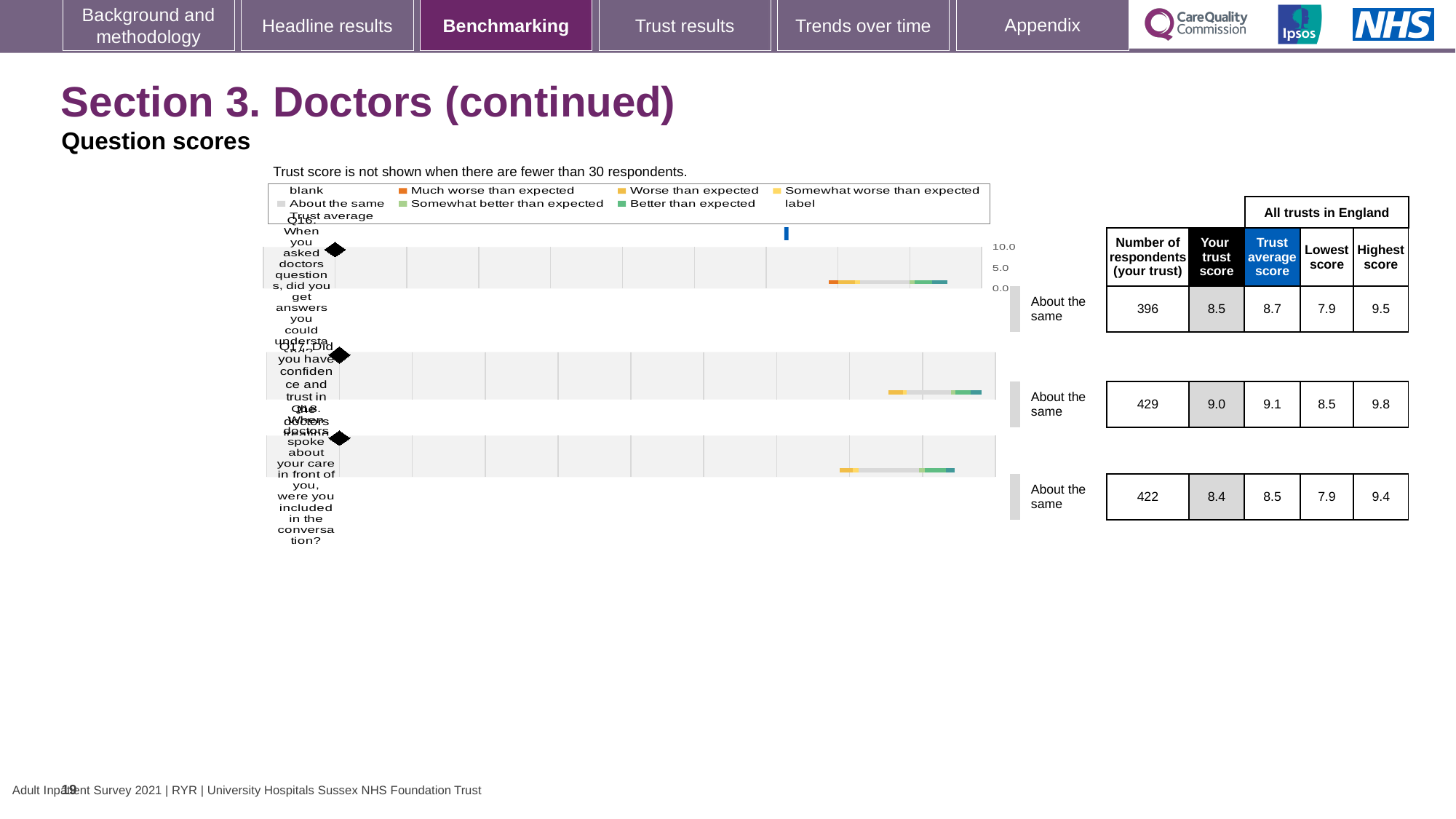
What is the 'Your trust score' for Q16 (When you asked doctors questions, did you get answers you could understand)? 8.5 Which question has the highest 'Your trust score'? Q17 What benchmark category is shown for Q18? About the same For Q16, which is larger: the 'Your trust score' or the 'Trust average score'? Trust average score What kind of chart is used to show the question scores on this slide? bar chart Which question has the lowest 'Your trust score'? Q18 What is the trust average score for Q18 (When doctors spoke about your care in front of you, were you included in the conversation)? 8.5 How many questions (categories) are plotted in the chart? 3 For Q16, what is the difference between the highest score and the 'Your trust score'? 1.0 For Q17, what is the difference between the highest score and the lowest score across all trusts in England? 1.3 How many respondents does the table show for Q17 (Did you have confidence and trust in the doctors treating you)? 429 What is the maximum value shown on the chart's score axis? 10.0